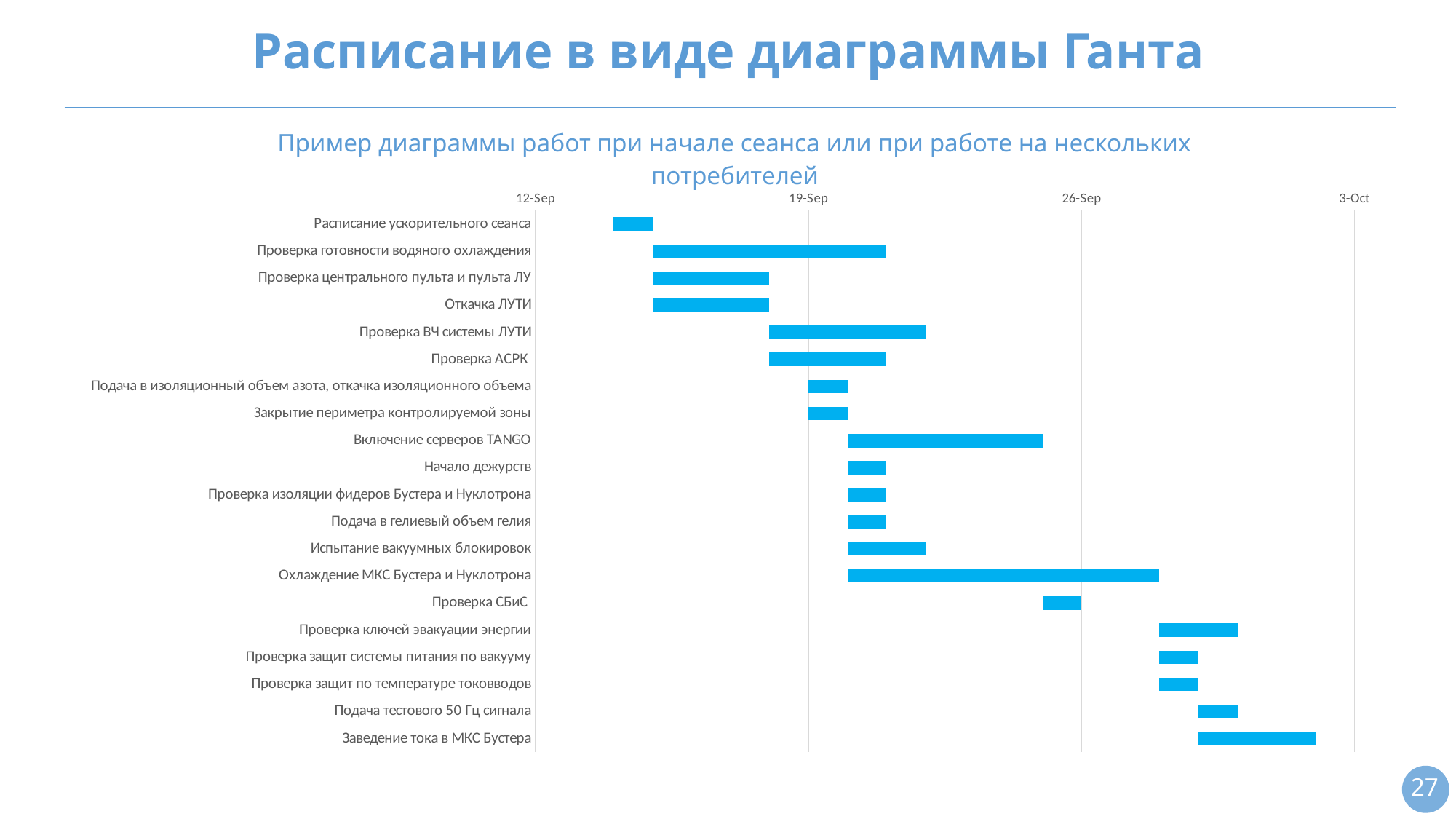
What is the title of the chart? Пример диаграммы работ при начале сеанса или при работе на нескольких потребителей What kind of chart is shown on the slide? Bar chart (Gantt chart) Does the bar for Проверка ключей эвакуации энергии start before or after 26-Sep? after What is the first date label shown on the horizontal axis? 12-Sep How many tasks (categories) are listed on the vertical axis of the chart? 20 Which bar is longer: Включение серверов TANGO or Начало дежурств? Включение серверов TANGO Which bar is longer: Проверка готовности водяного охлаждения or Откачка ЛУТИ? Проверка готовности водяного охлаждения Does the bar for Проверка СБиС start before or after 19-Sep? after Which task has the longest bar in the chart? Охлаждение МКС Бустера и Нуклотрона Does the bar for Расписание ускорительного сеанса end before or after 19-Sep? before Which task ends latest in the chart? Заведение тока в МКС Бустера Which task starts earliest in the chart? Расписание ускорительного сеанса